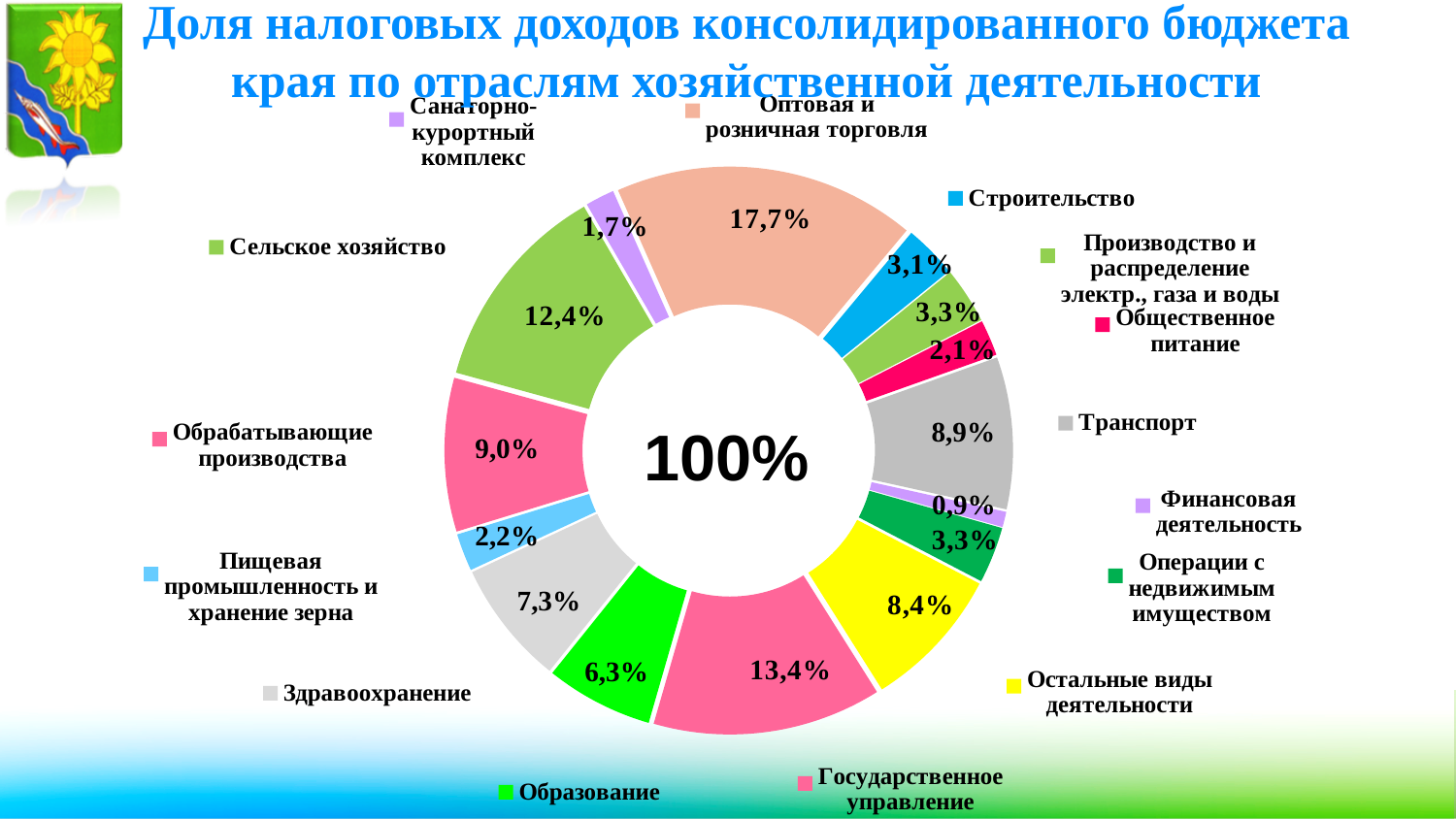
What share is shown for Сельское хозяйство? 12,4% What share is shown for Транспорт? 8,9% How many categories are shown in the chart? 15 Which category has the smallest share in the chart? Финансовая деятельность Which has a larger share: Здравоохранение or Образование? Здравоохранение What is the difference between the shares of Сельское хозяйство and Обрабатывающие производства? 3,4% What share does Оптовая и розничная торговля have in the chart? 17,7% Which category has the largest share in the chart? Оптовая и розничная торговля What value is printed in the centre of the chart? 100% What share is shown for Государственное управление? 13,4% What is the difference between the shares of Оптовая и розничная торговля and Государственное управление? 4,3% What kind of chart is shown on the slide? Pie (doughnut) chart